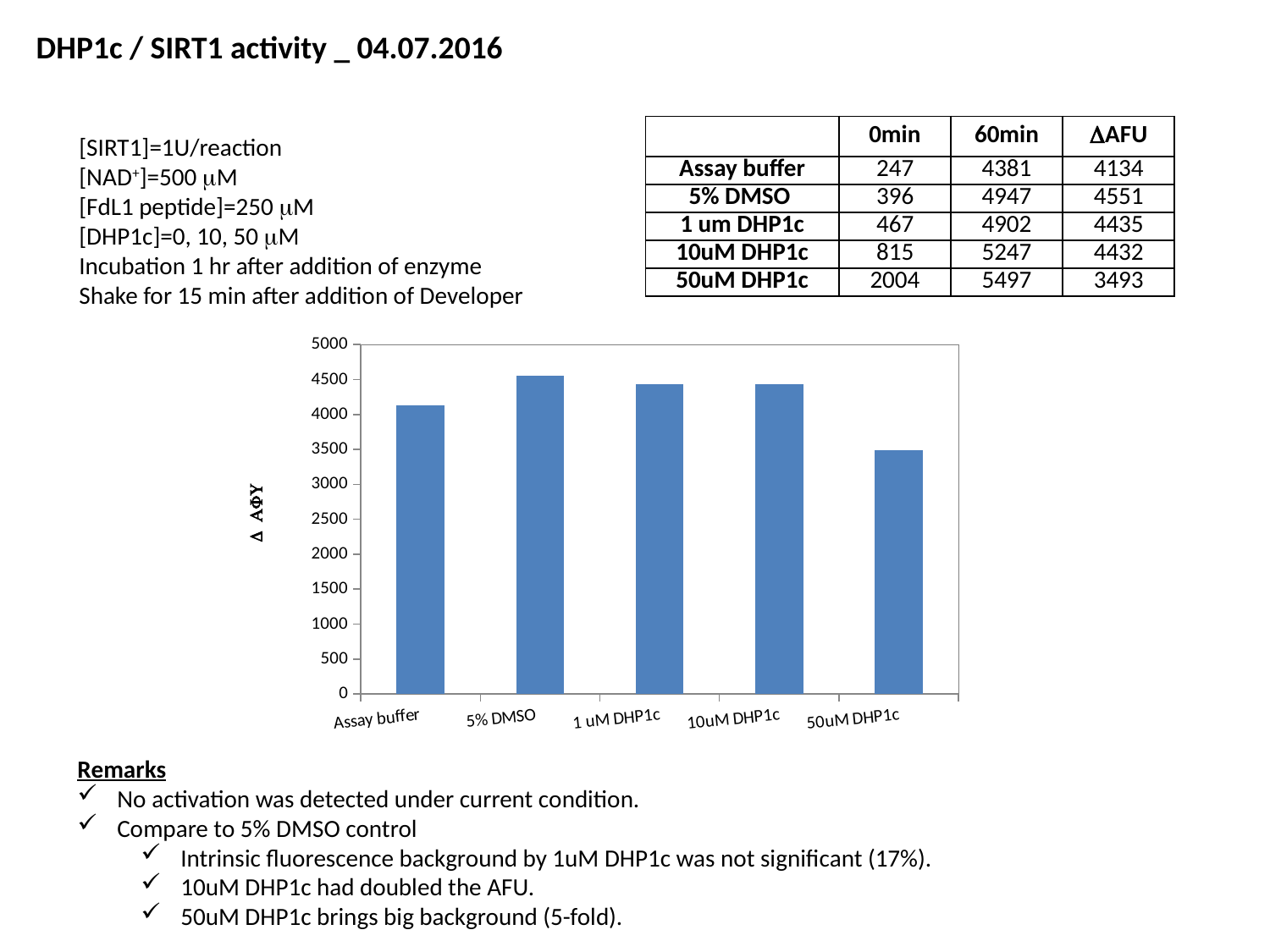
Using the ΔAFU values in the table, what is the difference between the Assay buffer bar and the 50uM DHP1c bar? 641 Is the bar for Assay buffer greater or less than 4000? greater According to the table on the slide, what is the ΔAFU value plotted for Assay buffer? 4134 Which category has the lowest bar in the chart? 50uM DHP1c What kind of chart is shown on the slide? bar chart Which bar is taller, 1 uM DHP1c or 50uM DHP1c? 1 uM DHP1c Which bar is taller, Assay buffer or 5% DMSO? 5% DMSO Is the bar for 10uM DHP1c greater or less than 4000? greater According to the table on the slide, what is the ΔAFU value plotted for 50uM DHP1c? 3493 Which category has the highest bar in the chart? 5% DMSO How many categories are plotted on the x axis of the chart? 5 Is the bar for 50uM DHP1c greater or less than 4000? less